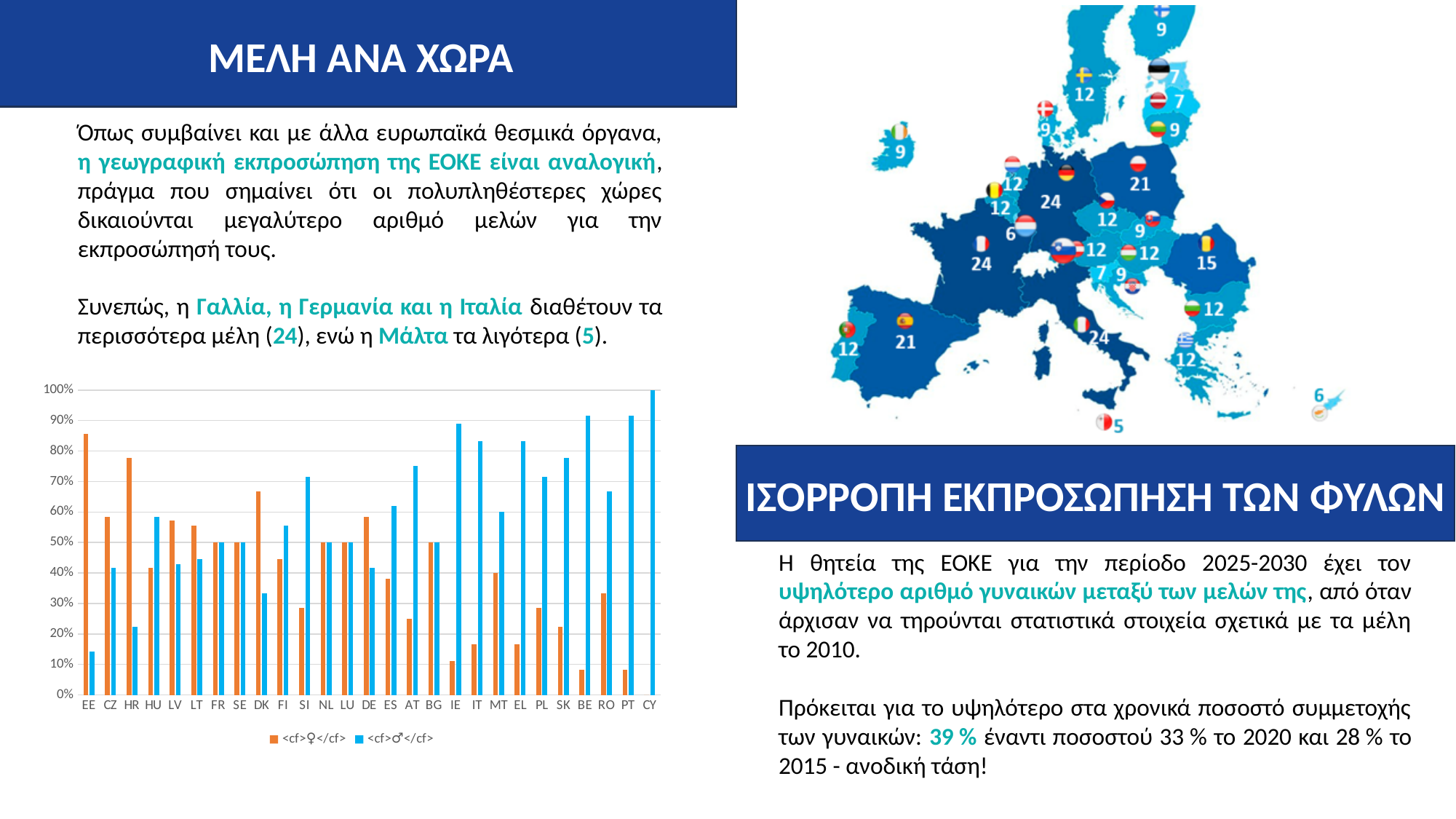
How many series does the legend of the bar chart list? 2 In the bar chart, is the orange (female) bar for EE greater or less than 80%? greater In the bar chart, which country has the lowest blue (male) bar? EE In the bar chart, which country has the highest orange (female) bar? EE In the bar chart, what is the value of the orange (female) bar for FR? 50% What kind of chart is shown at the bottom left of the slide? bar chart In the bar chart, what is the value of the blue (male) bar for NL? 50% How many country categories are shown on the x axis of the bar chart? 27 In the bar chart, what is the value of the blue (male) bar for CY? 100% In the bar chart, which country has the highest blue (male) bar? CY In the bar chart, is the orange (female) bar for PT greater or less than 10%? less In the bar chart, which is larger for HR: the orange (female) bar or the blue (male) bar? the orange (female) bar